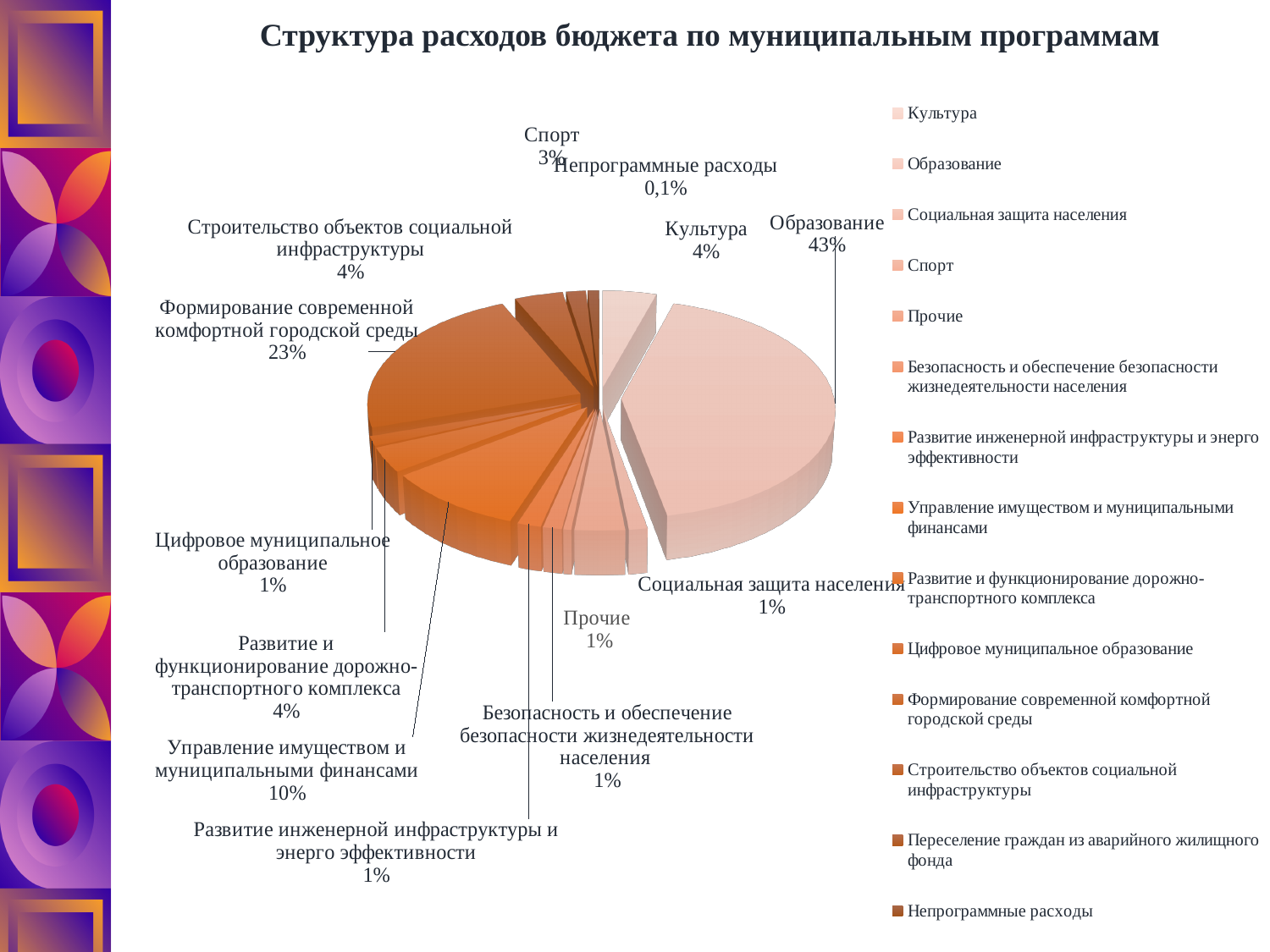
What share is shown for Непрограммные расходы? 0,1% What share is shown for Управление имуществом и муниципальными финансами? 10% What is the title of the chart? Структура расходов бюджета по муниципальным программам Which is larger: the share for Управление имуществом и муниципальными финансами or the share for Культура? Управление имуществом и муниципальными финансами What share of the pie does Образование have? 43% Which category has the largest share of the pie? Образование Which labelled category has the smallest share of the pie? Непрограммные расходы What share is shown for Спорт? 3% By how many percentage points does Образование exceed Формирование современной комфортной городской среды? 20 What share is shown for Формирование современной комфортной городской среды? 23% What kind of chart is shown on the slide? Pie chart How many categories does the legend list? 14